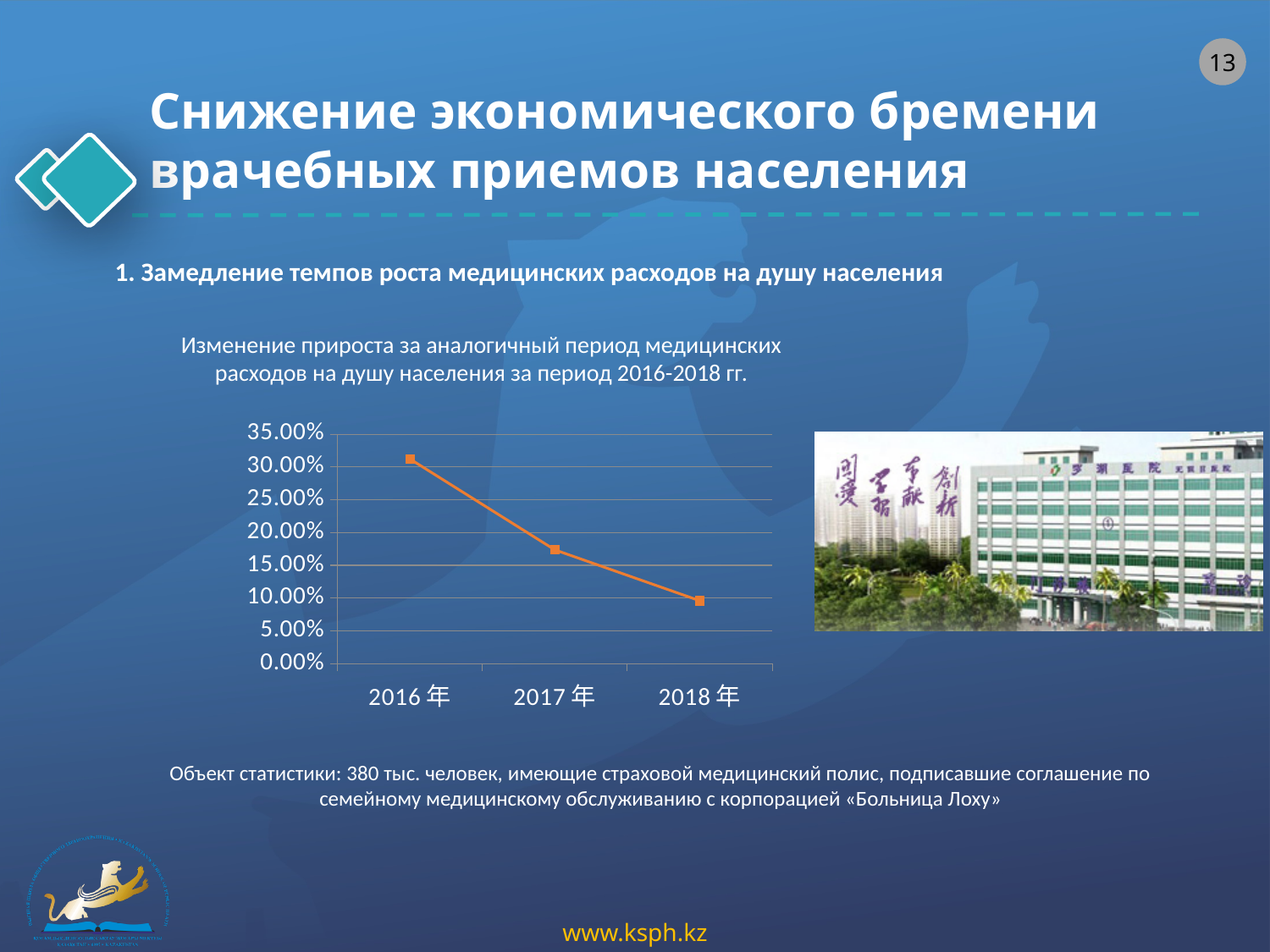
Is the value for 2017年 greater or less than 20.00%? less Which is larger, the value for 2017年 or the value for 2018年? 2017年 Is the value for 2016年 greater or less than 25.00%? greater Is the value for 2018年 greater or less than 15.00%? less What is the highest value shown on the chart's vertical axis? 35.00% What period does the chart's title say the data covers? 2016-2018 гг. Which year has the lowest value on the chart? 2018年 Which year has the highest value on the chart? 2016年 How many data points are plotted on the chart? 3 What kind of chart is shown on the slide? line chart Do the values rise or fall from 2016年 to 2018年? fall